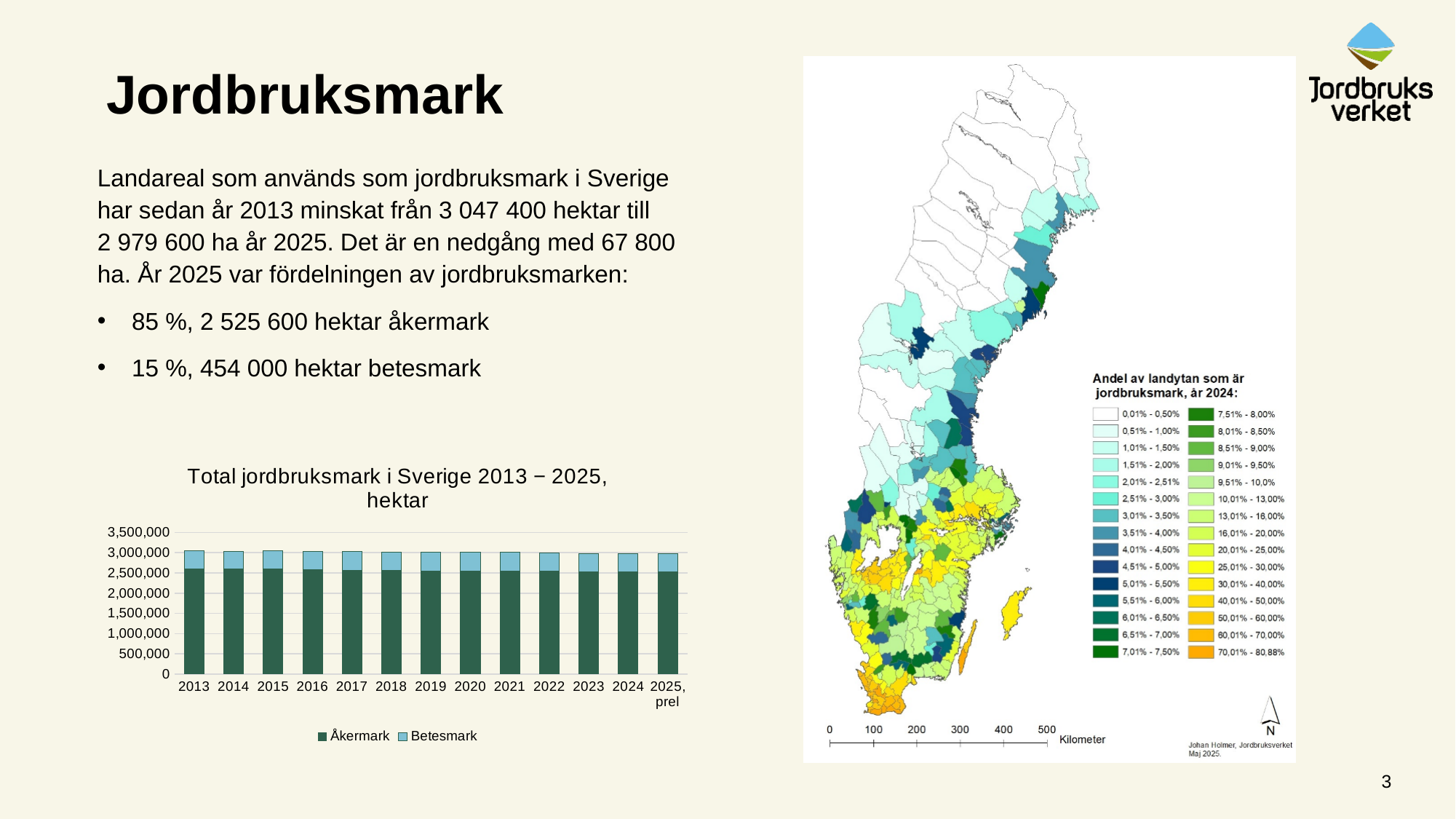
How many years (categories) are shown on the x axis of the bar chart 'Total jordbruksmark i Sverige 2013 − 2025, hektar'? 13 In the bar chart 'Total jordbruksmark i Sverige 2013 − 2025, hektar', which series is larger in 2013, Åkermark or Betesmark? Åkermark What is the label of the last category on the x axis of the bar chart 'Total jordbruksmark i Sverige 2013 − 2025, hektar'? 2025, prel In the bar chart 'Total jordbruksmark i Sverige 2013 − 2025, hektar', is the Åkermark value for 2025, prel greater or less than 3,000,000? less What kind of chart is the chart titled 'Total jordbruksmark i Sverige 2013 − 2025, hektar'? Stacked bar chart In the bar chart 'Total jordbruksmark i Sverige 2013 − 2025, hektar', is the Betesmark value for 2020 greater or less than 1,000,000? less In the bar chart 'Total jordbruksmark i Sverige 2013 − 2025, hektar', do the total bar heights rise or fall from 2013 to 2025? Fall Which series are listed in the legend of the bar chart 'Total jordbruksmark i Sverige 2013 − 2025, hektar'? Åkermark and Betesmark In the bar chart 'Total jordbruksmark i Sverige 2013 − 2025, hektar', is the total stacked bar for 2013 greater or less than 3,500,000? less How many series does the legend of the bar chart 'Total jordbruksmark i Sverige 2013 − 2025, hektar' list? 2